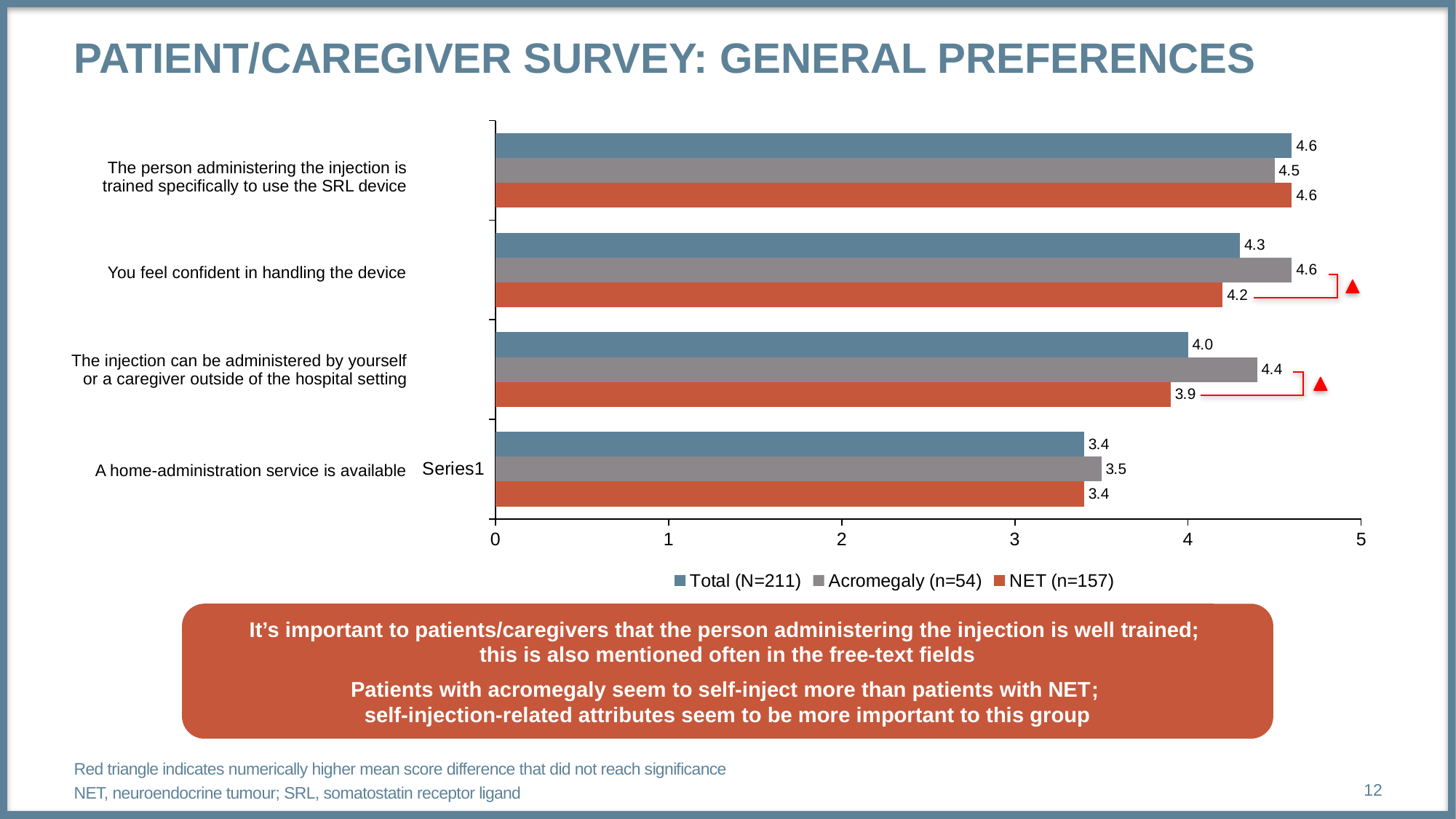
Which category has the lowest Total (N=211) value? A home-administration service is available What is the NET (n=157) value for "A home-administration service is available"? 3.4 How many categories are shown on the chart? 4 What is the difference between the Acromegaly (n=54) and NET (n=157) values for "The injection can be administered by yourself or a caregiver outside of the hospital setting"? 0.5 Which category has the highest NET (n=157) value? The person administering the injection is trained specifically to use the SRL device For "You feel confident in handling the device", which is larger: the Acromegaly (n=54) value or the NET (n=157) value? Acromegaly (n=54) Which series is shown in orange-red on the chart? NET (n=157) What is the Total (N=211) value for "You feel confident in handling the device"? 4.3 What kind of chart is shown on the slide? Bar chart What is the Acromegaly (n=54) value for "The person administering the injection is trained specifically to use the SRL device"? 4.5 How many series does the legend list? 3 What is the Acromegaly (n=54) value for "The injection can be administered by yourself or a caregiver outside of the hospital setting"? 4.4